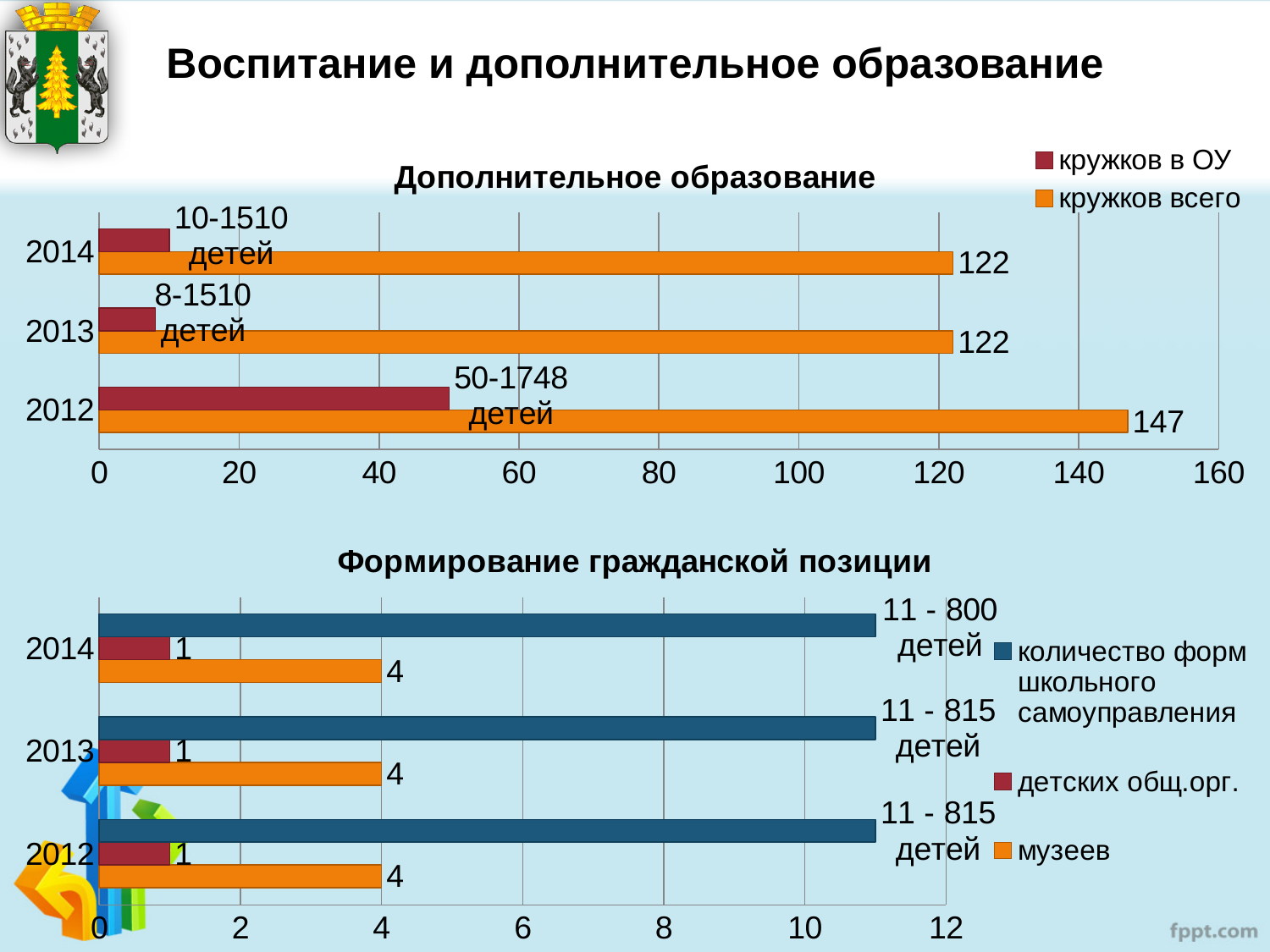
In the chart titled "Дополнительное образование", what is the value of "кружков всего" for 2014? 122 In the chart titled "Дополнительное образование", what is the value of "кружков всего" for 2012? 147 In the chart titled "Дополнительное образование", what kind of chart is it? bar chart In the chart titled "Формирование гражданской позиции", which is larger for 2012: "музеев" or "детских общ.орг."? музеев In the chart titled "Формирование гражданской позиции", how many series does the legend list? 3 In the chart titled "Формирование гражданской позиции", how many years are shown on the vertical axis? 3 In the chart titled "Дополнительное образование", how many series does the legend list? 2 In the chart titled "Дополнительное образование", what is the difference between "кружков всего" in 2012 and in 2013? 25 In the chart titled "Формирование гражданской позиции", what is the value of "музеев" for 2013? 4 In the chart titled "Формирование гражданской позиции", what is the value of "детских общ.орг." for 2014? 1 In the chart titled "Дополнительное образование", is the value of "кружков в ОУ" for 2012 greater or less than 40? greater In the chart titled "Дополнительное образование", which year has the highest value for "кружков всего"? 2012